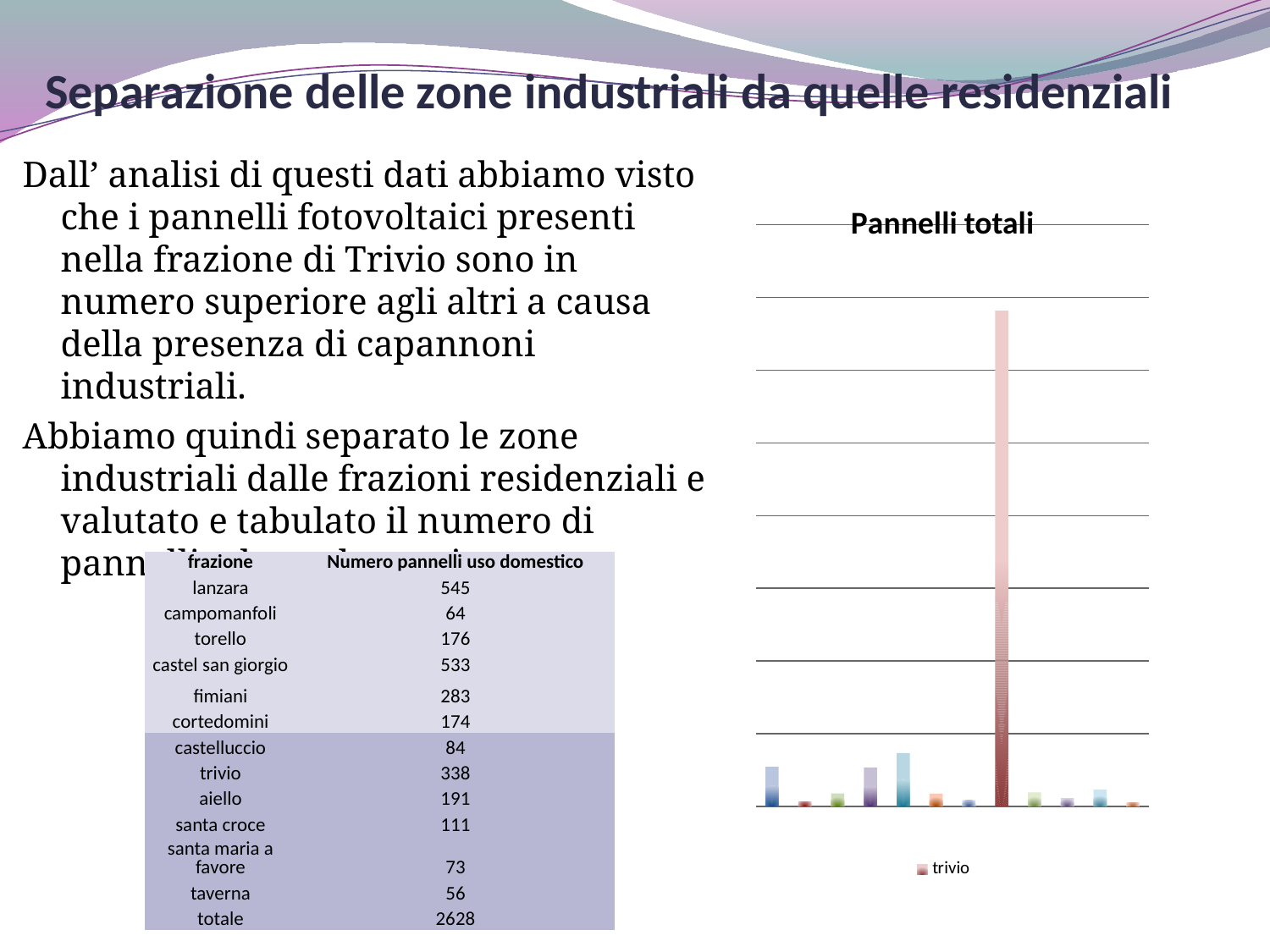
What is the only legend entry shown under the 'Pannelli totali' chart? trivio How many entries does the legend of the 'Pannelli totali' chart show? 1 How many bars are plotted in the 'Pannelli totali' chart? 12 Which category has the highest value in the 'Pannelli totali' chart? trivio What is the title of the chart on the right of the slide? Pannelli totali What kind of chart is the 'Pannelli totali' chart? bar chart